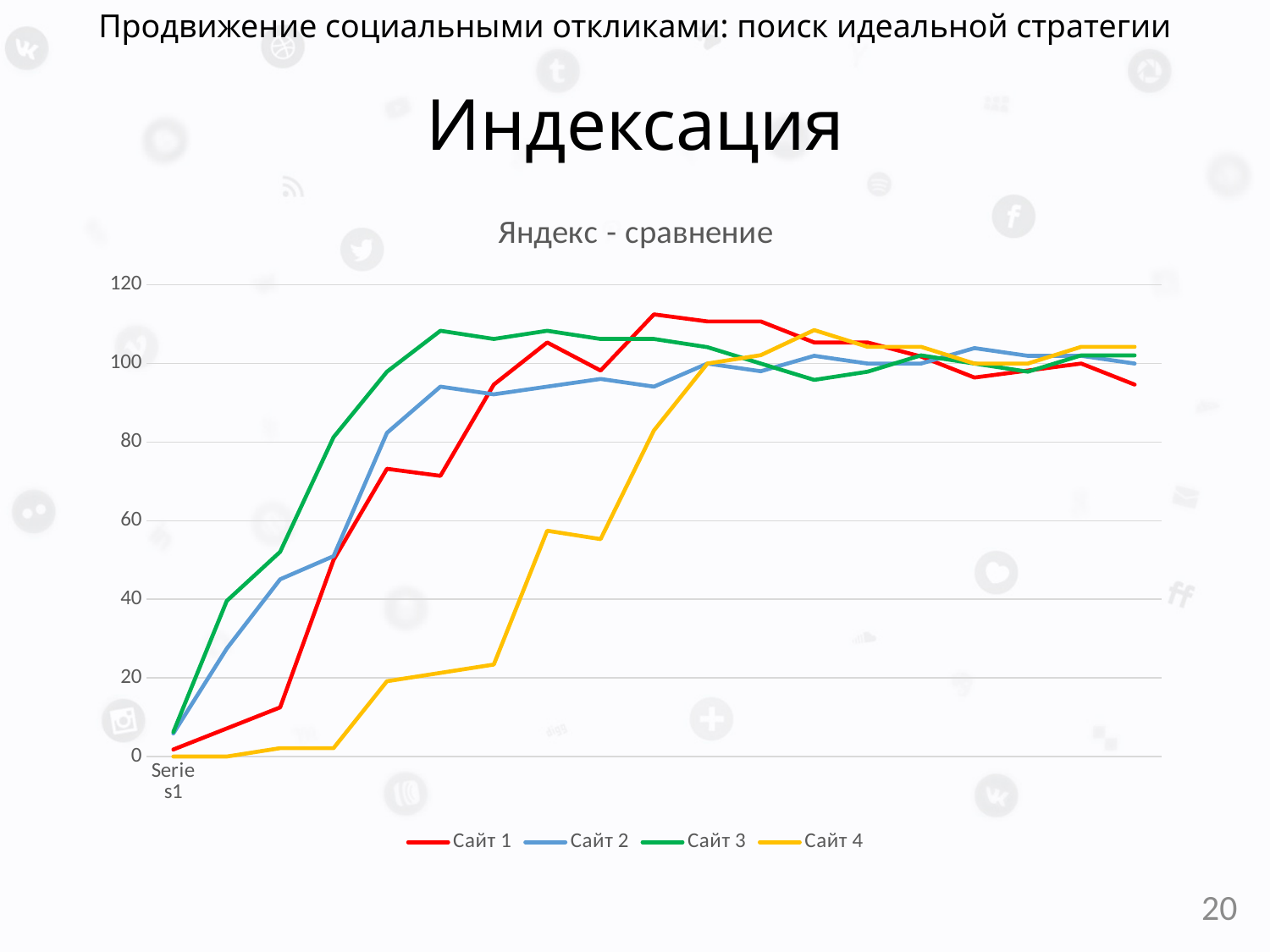
What kind of chart is shown on the slide? line chart Is the last value for Сайт 1 greater or less than 100? less Do the values for Сайт 4 generally rise or fall along the x axis? rise Which series reaches the highest value on the chart? Сайт 1 Is the first value for Сайт 4 greater or less than 20? less Is the highest value reached by Сайт 1 greater or less than 100? greater Which series is drawn in red? Сайт 1 At the fifth point along the x axis, which is larger: Сайт 3 or Сайт 1? Сайт 3 How many series does the legend list? 4 Which series has the lowest values in the first half of the x axis? Сайт 4 What is the title of the chart? Яндекс - сравнение